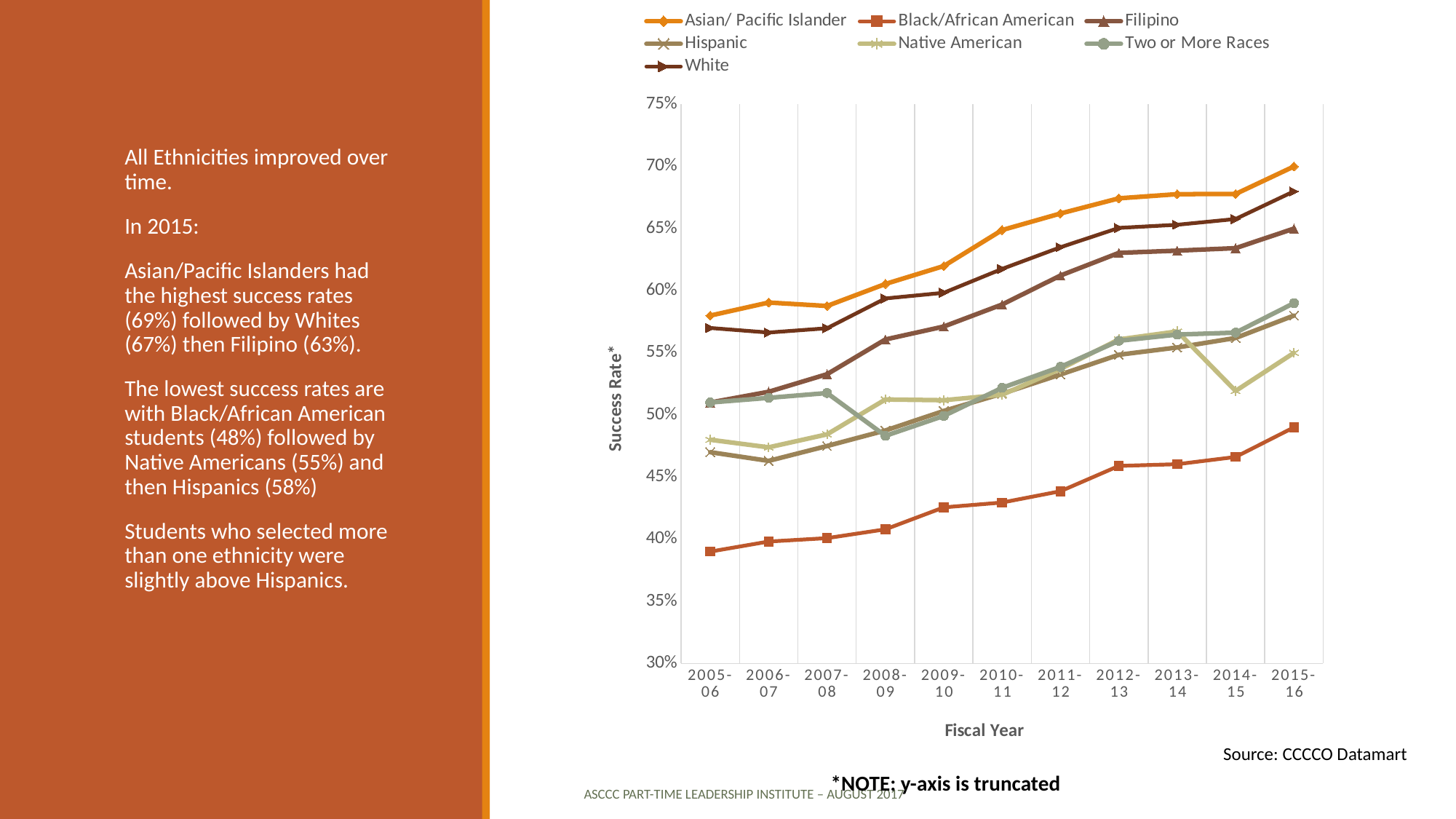
How many series does the legend list? 7 What kind of chart is shown on the slide? line chart In 2015-16, which is higher: the success rate for White students or for Filipino students? White Is the success rate for Black/African American students in 2015-16 greater or less than 50%? less Which ethnicity has the lowest success rate in 2015-16? Black/African American Which ethnicity has the lowest success rate in 2005-06? Black/African American What is the title of the y axis? Success Rate* Is the success rate for White students in 2015-16 greater or less than 65%? greater Does the success rate for Asian/ Pacific Islander students rise or fall from 2005-06 to 2015-16? rise Which ethnicity has the highest success rate in 2015-16? Asian/ Pacific Islander How many fiscal years are plotted along the x axis? 11 Is the success rate for Native American students in 2014-15 greater or less than 55%? less